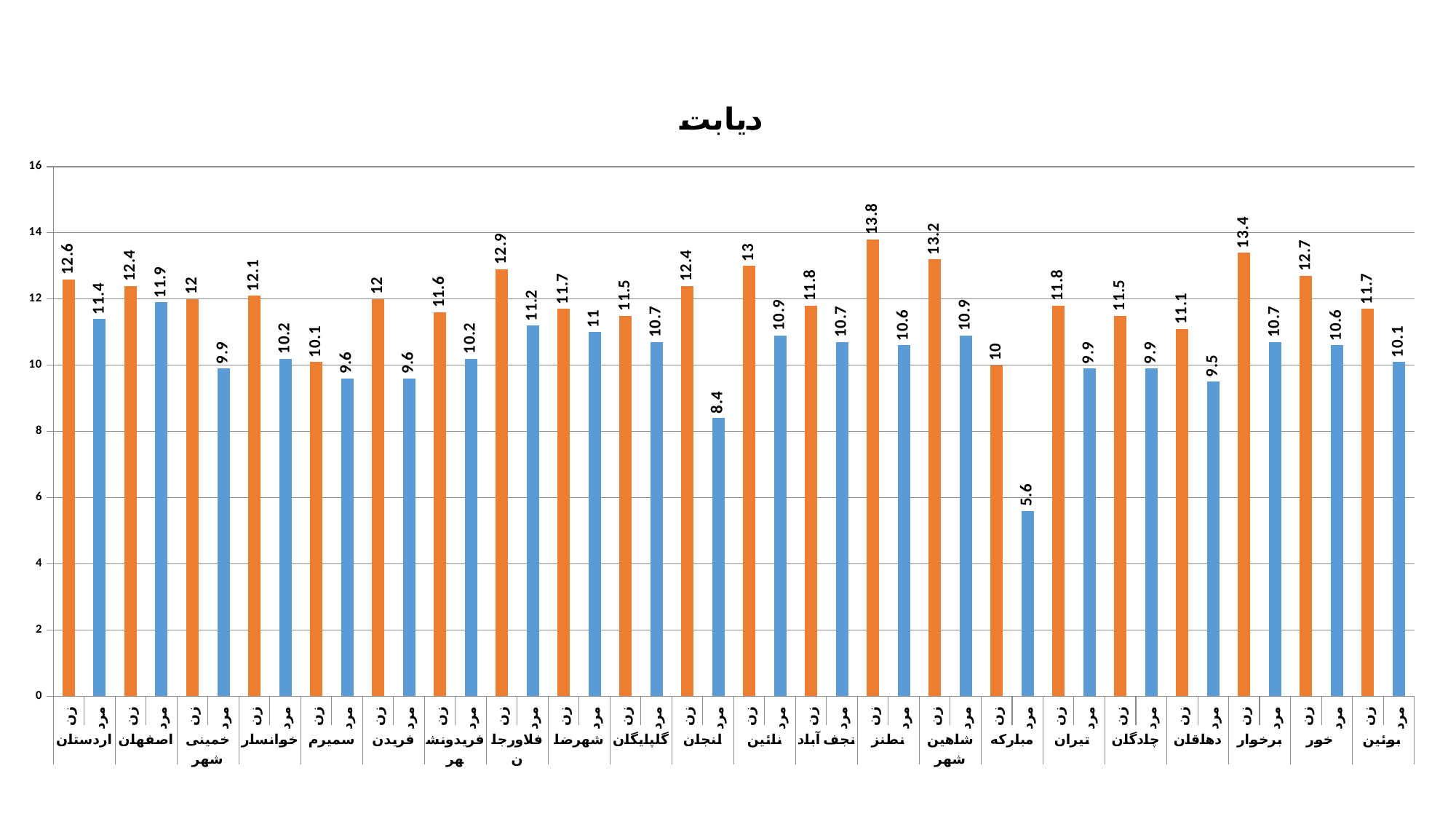
Which city has the highest value for زن? نطنز Which is larger, the زن value in برخوار or the زن value in شاهین شهر? برخوار What is the difference between the زن and مرد values in لنجان? 4 What is the difference between the زن and مرد values in مبارکه? 4.4 Which city has the lowest value for مرد? مبارکه What is the value for مرد in لنجان? 8.4 Which city has the highest value for مرد? اصفهان How many cities are shown on the x axis? 22 What kind of chart is this? bar chart What is the title of the chart? دیابت What is the value for مرد in مبارکه? 5.6 What is the value for زن in نطنز? 13.8